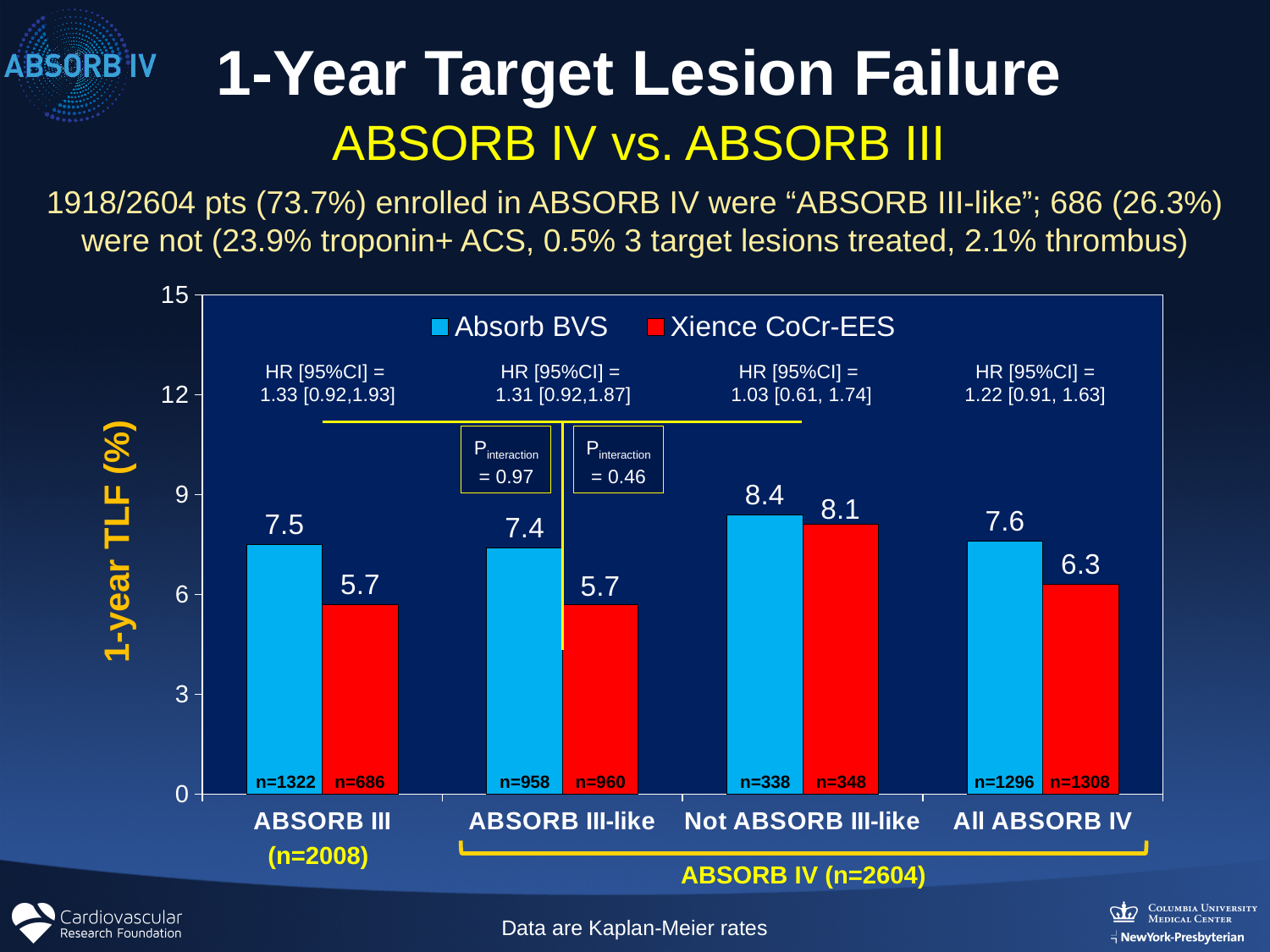
What is the 1-year TLF value for Absorb BVS in the ABSORB III group? 7.5 Which is larger in the All ABSORB IV group, the Absorb BVS value or the Xience CoCr-EES value? Absorb BVS What is the 1-year TLF value for Xience CoCr-EES in the Not ABSORB III-like group? 8.1 What is the difference between the Absorb BVS and Xience CoCr-EES values in the ABSORB III-like group? 1.7 How many series does the legend list? 2 Which category has the highest Absorb BVS value? Not ABSORB III-like Is the Absorb BVS value for the Not ABSORB III-like group greater or less than 6? greater What is the 1-year TLF value for Absorb BVS in the All ABSORB IV group? 7.6 How many categories are shown on the x axis? 4 What is the y-axis label of the chart? 1-year TLF (%) Which category has the lowest Xience CoCr-EES value? ABSORB III and ABSORB III-like (both 5.7) What kind of chart is shown on the slide? bar chart